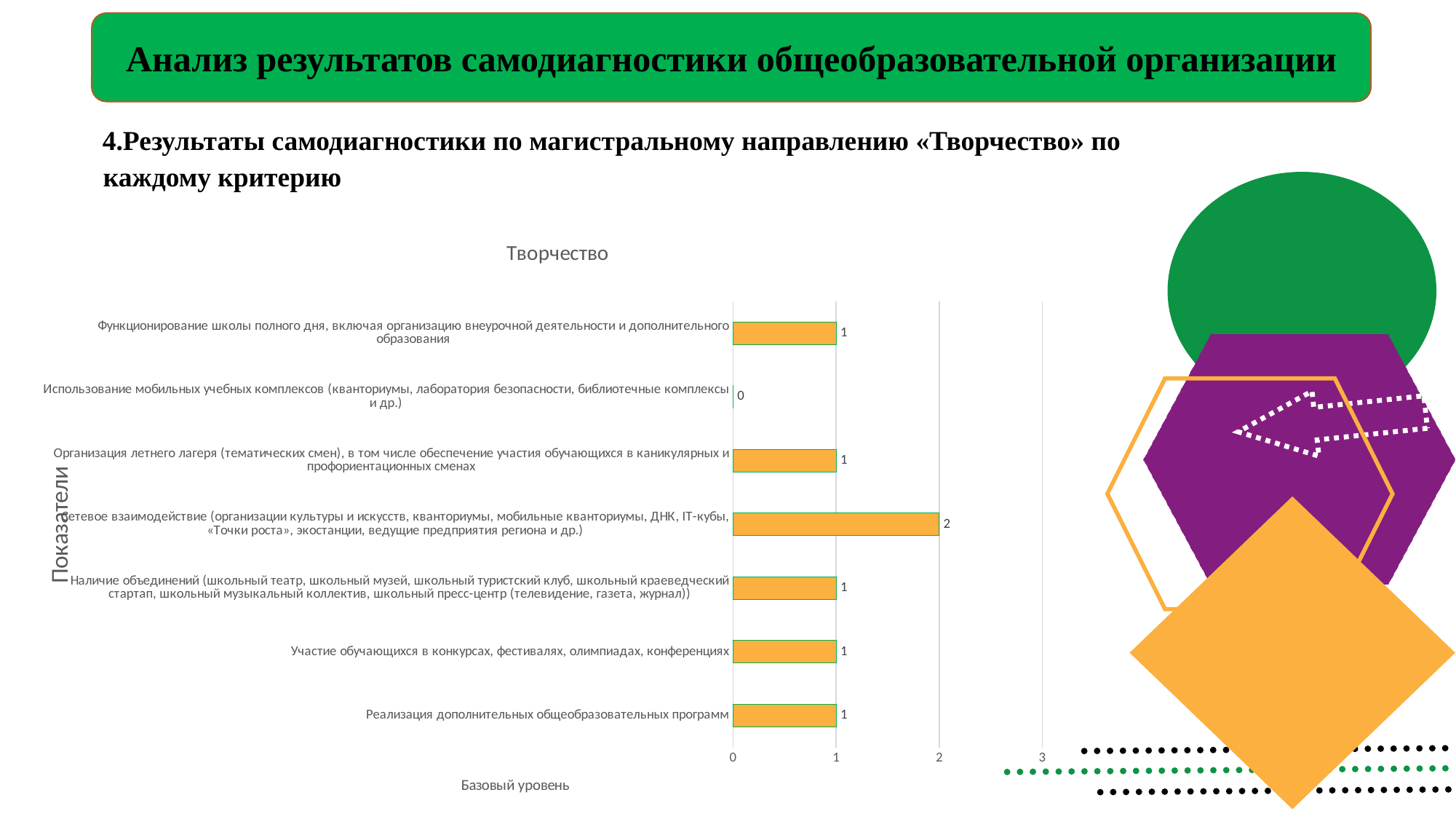
What is the difference between the value for «Сетевое взаимодействие» and the value for «Организация летнего лагеря (тематических смен)»? 1 Which category has the lowest value? Использование мобильных учебных комплексов (кванториумы, лаборатория безопасности, библиотечные комплексы и др.) Which is larger: the value for «Сетевое взаимодействие» or the value for «Функционирование школы полного дня»? Сетевое взаимодействие Which category has the highest value? Сетевое взаимодействие (организации культуры и искусств, кванториумы, мобильные кванториумы, ДНК, IT-кубы, «Точки роста», экостанции, ведущие предприятия региона и др.) What is the value for «Участие обучающихся в конкурсах, фестивалях, олимпиадах, конференциях»? 1 What is the value for «Реализация дополнительных общеобразовательных программ»? 1 What is the value for «Использование мобильных учебных комплексов (кванториумы, лаборатория безопасности, библиотечные комплексы и др.)»? 0 What type of chart is shown on the slide? bar chart How many categories are plotted in the chart? 7 What is the title of the chart? Творчество How many categories have a value of 1? 5 What is the label of the horizontal axis? Базовый уровень